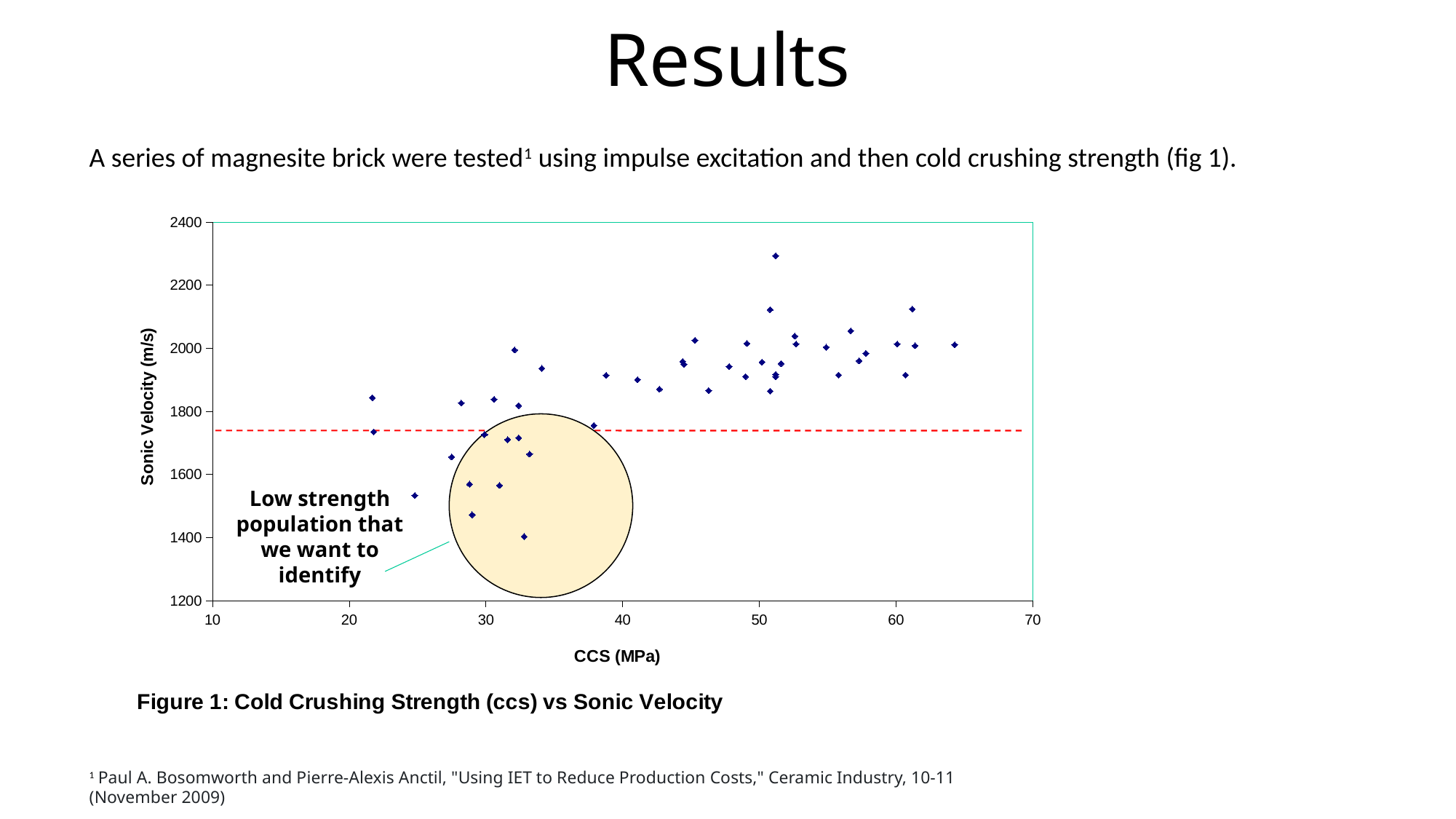
In Figure 1, is the sonic velocity of the rightmost point (at about 64 MPa) greater or less than 1900? greater What kind of chart is shown in Figure 1? scatter plot In Figure 1, is the sonic velocity of the lowest point greater or less than 1500? less In Figure 1, is the red dashed horizontal line at a sonic velocity greater or less than 1800? less In Figure 1, does sonic velocity generally rise or fall as CCS increases along the x axis? rise What does the text next to the shaded circle in Figure 1 say? Low strength population that we want to identify In Figure 1, are most of the plotted points above or below the red dashed line? above What is the label of the x axis in Figure 1? CCS (MPa)